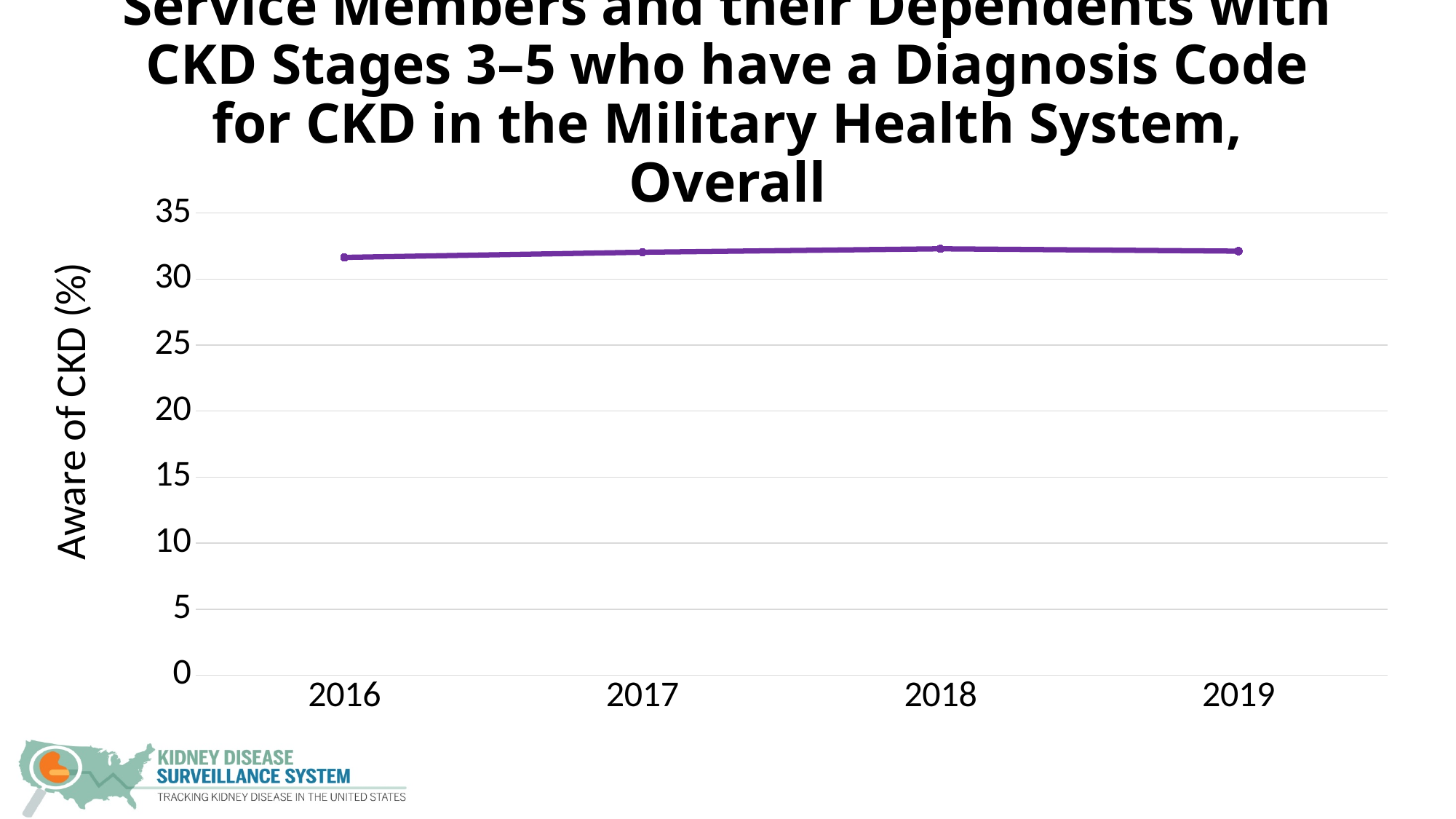
What colour is the plotted line? purple What is the highest value shown on the y axis? 35 Is the value for 2019 greater or less than 35? less Is the value for 2017 greater or less than 30? greater What is the first year shown on the x axis? 2016 What kind of chart is shown on the slide? line chart How many years are plotted along the x axis? 4 Is the value for 2018 greater or less than 25? greater What is the label on the y axis? Aware of CKD (%)